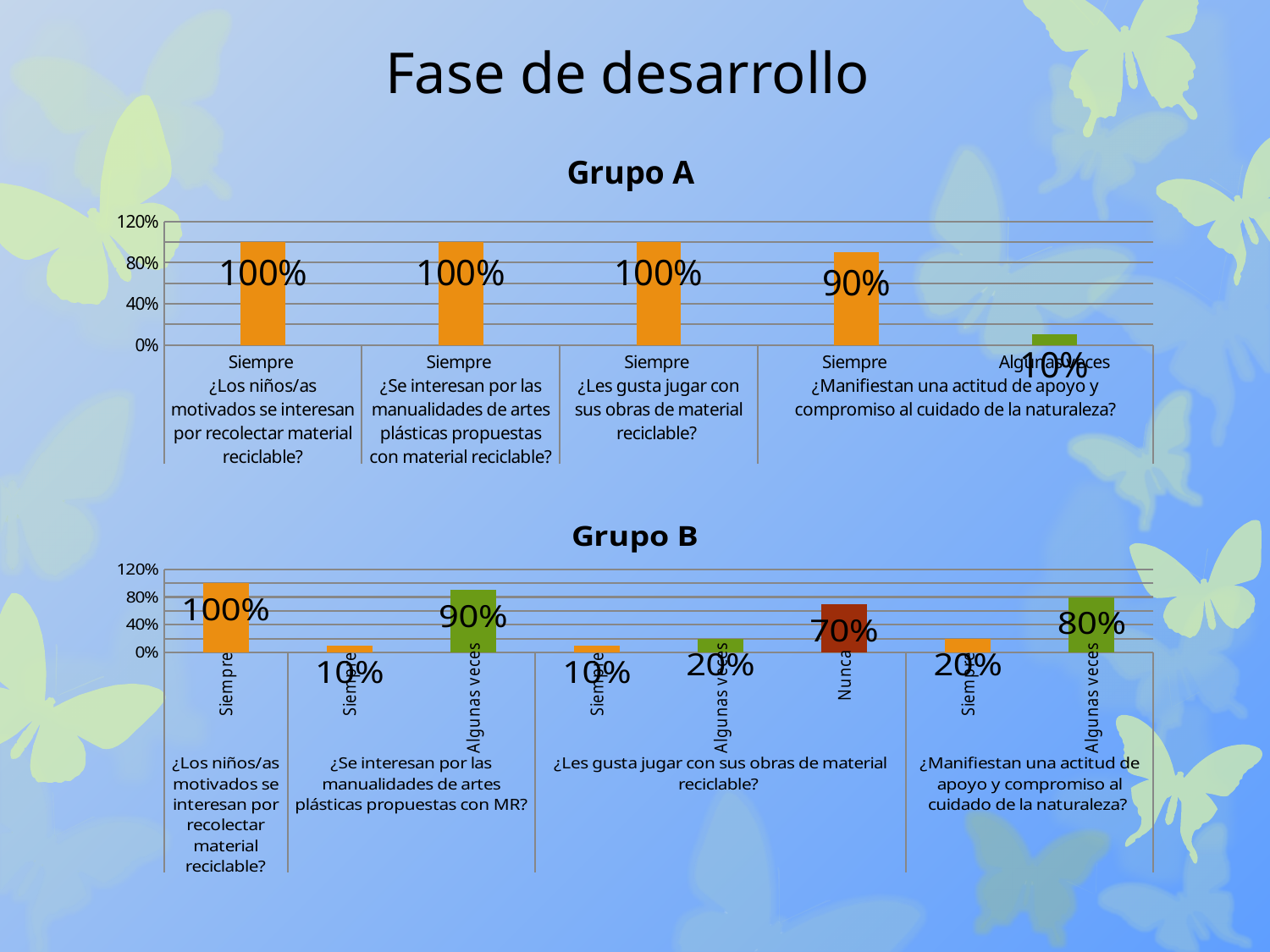
In the Grupo A chart, how many bars are plotted? 5 In the Grupo B chart, which bar has the highest value? Siempre, ¿Los niños/as motivados se interesan por recolectar material reciclable? (100%) In the Grupo B chart, how many bars are plotted? 8 In the Grupo B chart, what is the value for "Nunca" for the question "¿Les gusta jugar con sus obras de material reciclable?"? 70% In the Grupo B chart, which is larger: the "Nunca" value for "¿Les gusta jugar con sus obras de material reciclable?" or the "Algunas veces" value for "¿Manifiestan una actitud de apoyo y compromiso al cuidado de la naturaleza?"? Algunas veces for ¿Manifiestan una actitud de apoyo y compromiso al cuidado de la naturaleza? (80%) What type of chart is the Grupo A chart? Bar chart In the Grupo A chart, what is the value for "Siempre" for the question "¿Manifiestan una actitud de apoyo y compromiso al cuidado de la naturaleza?"? 90% In the Grupo A chart, what is the value for "Algunas veces" for the question "¿Manifiestan una actitud de apoyo y compromiso al cuidado de la naturaleza?"? 10% In the Grupo B chart, what is the value for "Algunas veces" for the question "¿Manifiestan una actitud de apoyo y compromiso al cuidado de la naturaleza?"? 80% In the Grupo A chart, what is the value for "Siempre" for the question "¿Les gusta jugar con sus obras de material reciclable?"? 100% In the Grupo A chart, what is the difference between the "Siempre" and "Algunas veces" values for the question about apoyo y compromiso al cuidado de la naturaleza? 80% In the Grupo B chart, what is the value for "Algunas veces" for the question "¿Se interesan por las manualidades de artes plásticas propuestas con MR?"? 90%